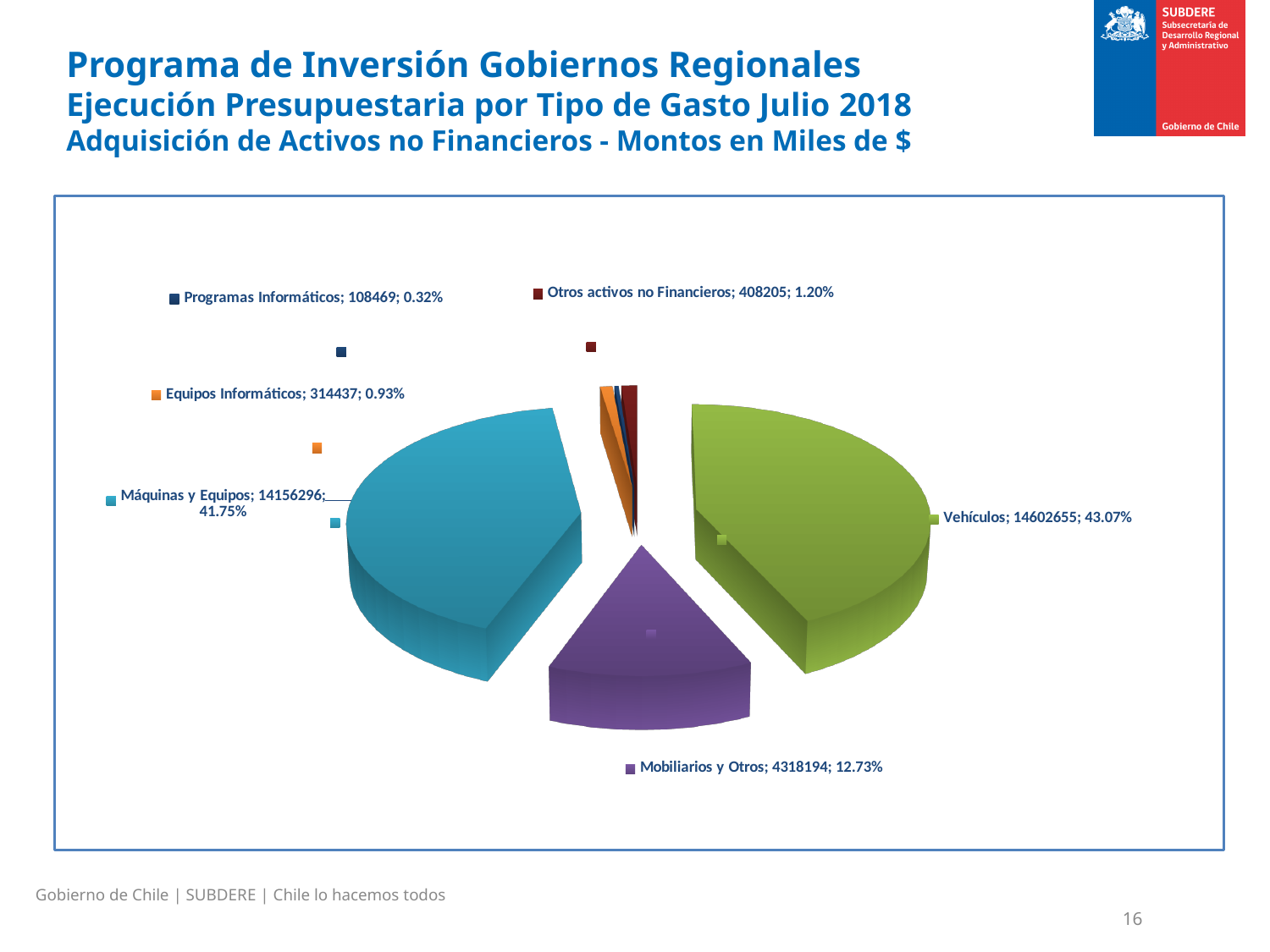
What is the difference between the values for Vehículos and Máquinas y Equipos? 446359 Which category has the largest value? Vehículos Which is larger, the value for Otros activos no Financieros or the value for Equipos Informáticos? Otros activos no Financieros What is the value for Vehículos? 14602655 What is the value for Mobiliarios y Otros? 4318194 What kind of chart is shown on the slide? Pie chart What is the value for Máquinas y Equipos? 14156296 Which category has the smallest value? Programas Informáticos What is the value for Programas Informáticos? 108469 How many categories (slices) does the pie chart have? 6 What share of the pie does Mobiliarios y Otros represent? 12.73% What share of the pie does Equipos Informáticos represent? 0.93%